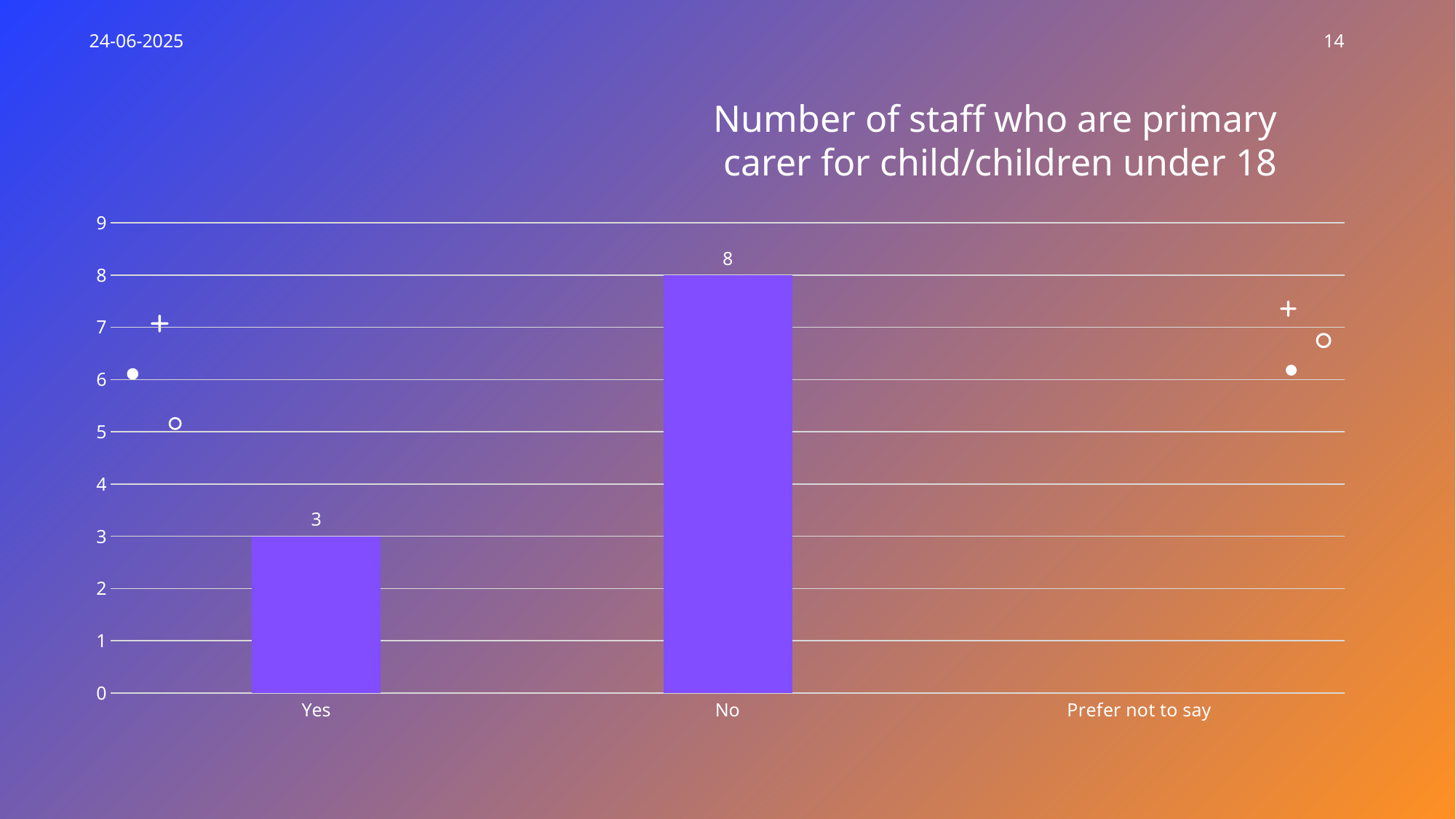
What is the value for No? 8 What is the highest value shown on the y axis? 9 Which category has the highest value? No What is the difference between the values for No and Yes? 5 How many categories are shown on the x axis? 3 Is the value for No greater or less than 5? greater Which is larger, the value for Yes or the value for No? No What is the value for Yes? 3 What kind of chart is shown on the slide? bar chart What is the total of the values for Yes and No? 11 Is the value for Yes greater or less than 4? less What is the title of the chart? Number of staff who are primary carer for child/children under 18